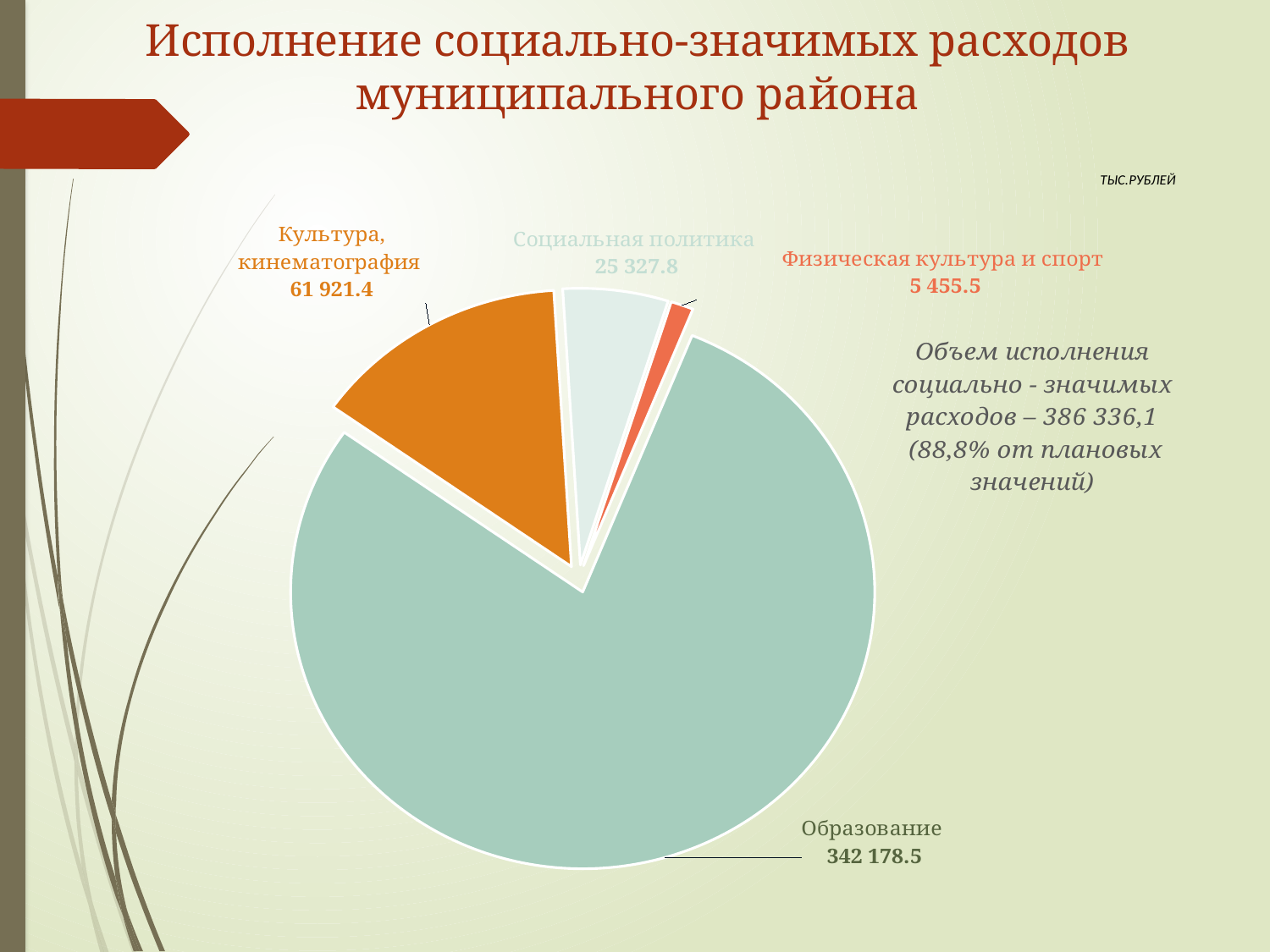
What is the value for Образование? 342 178.5 What is the difference between the values for Образование and Культура, кинематография? 280 257.1 What is the value for Физическая культура и спорт? 5 455.5 What is the difference between the values for Социальная политика and Физическая культура и спорт? 19 872.3 What kind of chart is shown on the slide? pie chart What is the value for Социальная политика? 25 327.8 Which category has the largest slice of the pie? Образование Which is larger, Культура, кинематография or Социальная политика? Культура, кинематография What is the value for Культура, кинематография? 61 921.4 How many categories are shown in the pie chart? 4 Which category has the smallest slice of the pie? Физическая культура и спорт In what units are the values on the chart given? тыс. рублей